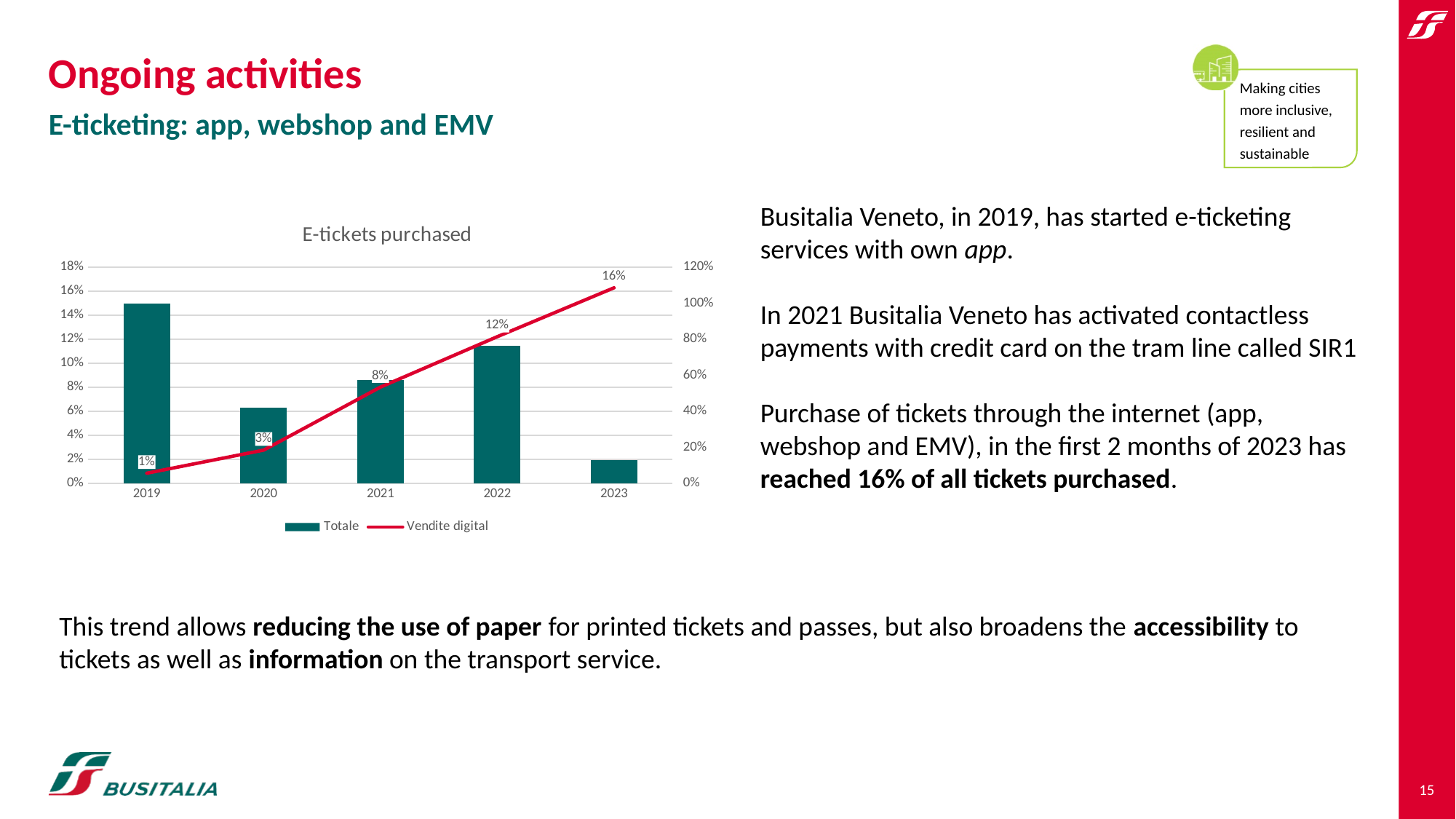
Which year has the tallest Totale bar in the E-tickets purchased chart? 2019 Is the Totale bar for 2019 greater or less than 14%? greater What is the Vendite digital value for 2021 in the E-tickets purchased chart? 8% Which year has the shortest Totale bar in the E-tickets purchased chart? 2023 How many years are shown on the x axis of the E-tickets purchased chart? 5 What is the Vendite digital value for 2022 in the E-tickets purchased chart? 12% What is the Vendite digital value for 2019 in the E-tickets purchased chart? 1% How many series does the legend of the E-tickets purchased chart list? 2 What is the Vendite digital value for 2023 in the E-tickets purchased chart? 16% Does the Vendite digital line rise or fall from 2019 to 2023? rise By how many percentage points did the Vendite digital value increase from 2019 to 2023? 15 percentage points